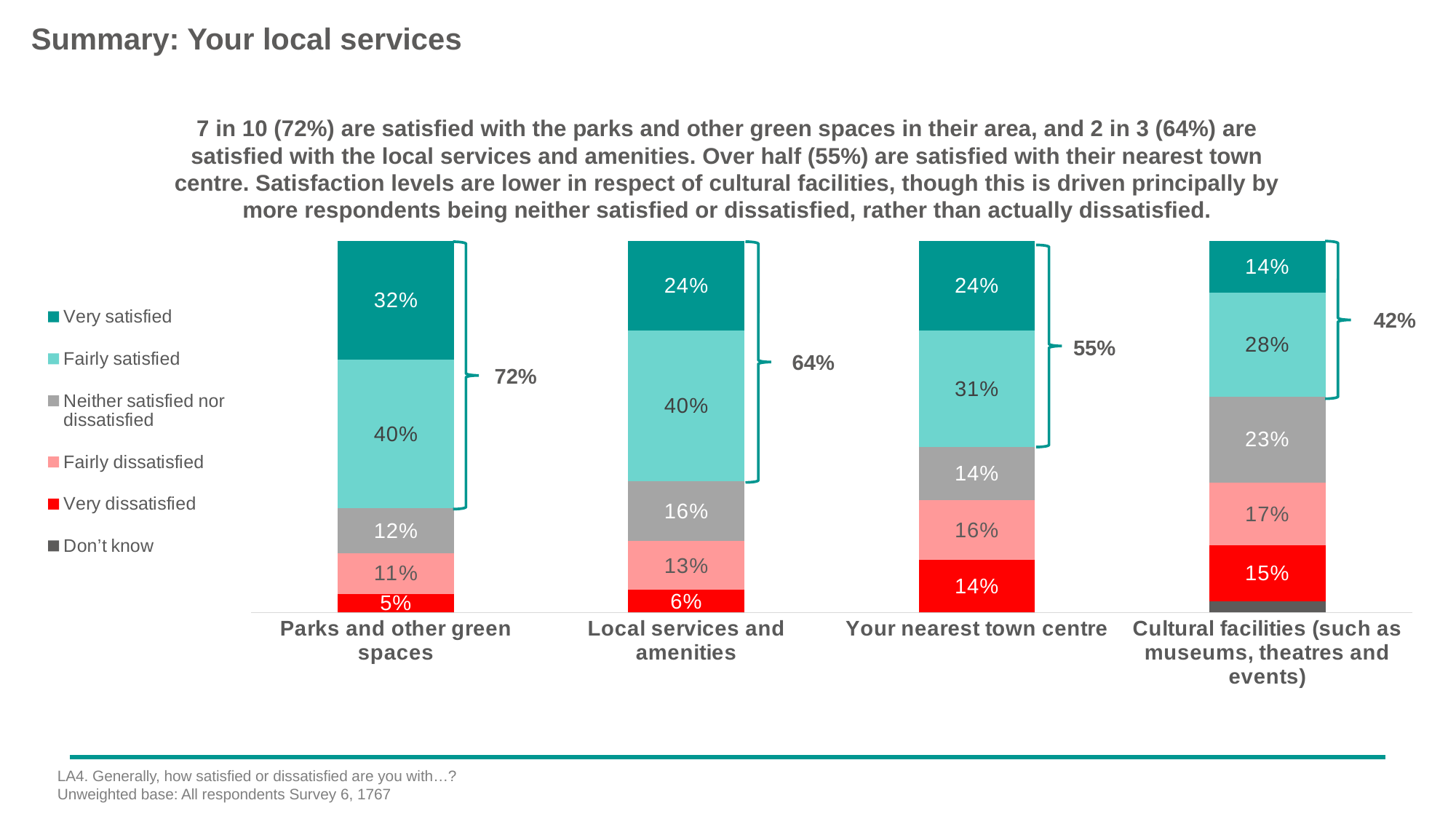
What is the combined share of very satisfied and fairly satisfied respondents for your nearest town centre, as shown by the bracket? 55% How many series does the legend list? 6 What percentage of respondents are fairly dissatisfied with cultural facilities (such as museums, theatres and events)? 17% Which category has the highest share of very satisfied respondents? Parks and other green spaces How many categories are shown on the x axis of the chart? 4 What percentage of respondents are very satisfied with parks and other green spaces? 32% What colour represents the 'Very dissatisfied' series in the chart? Red Which category has the lowest share of very dissatisfied respondents? Parks and other green spaces What kind of chart is shown on the slide? Stacked bar chart What percentage of respondents are very dissatisfied with their nearest town centre? 14% Which has a larger share of respondents who are neither satisfied nor dissatisfied: local services and amenities or cultural facilities? Cultural facilities What is the difference in the fairly satisfied share between parks and other green spaces and cultural facilities? 12 percentage points